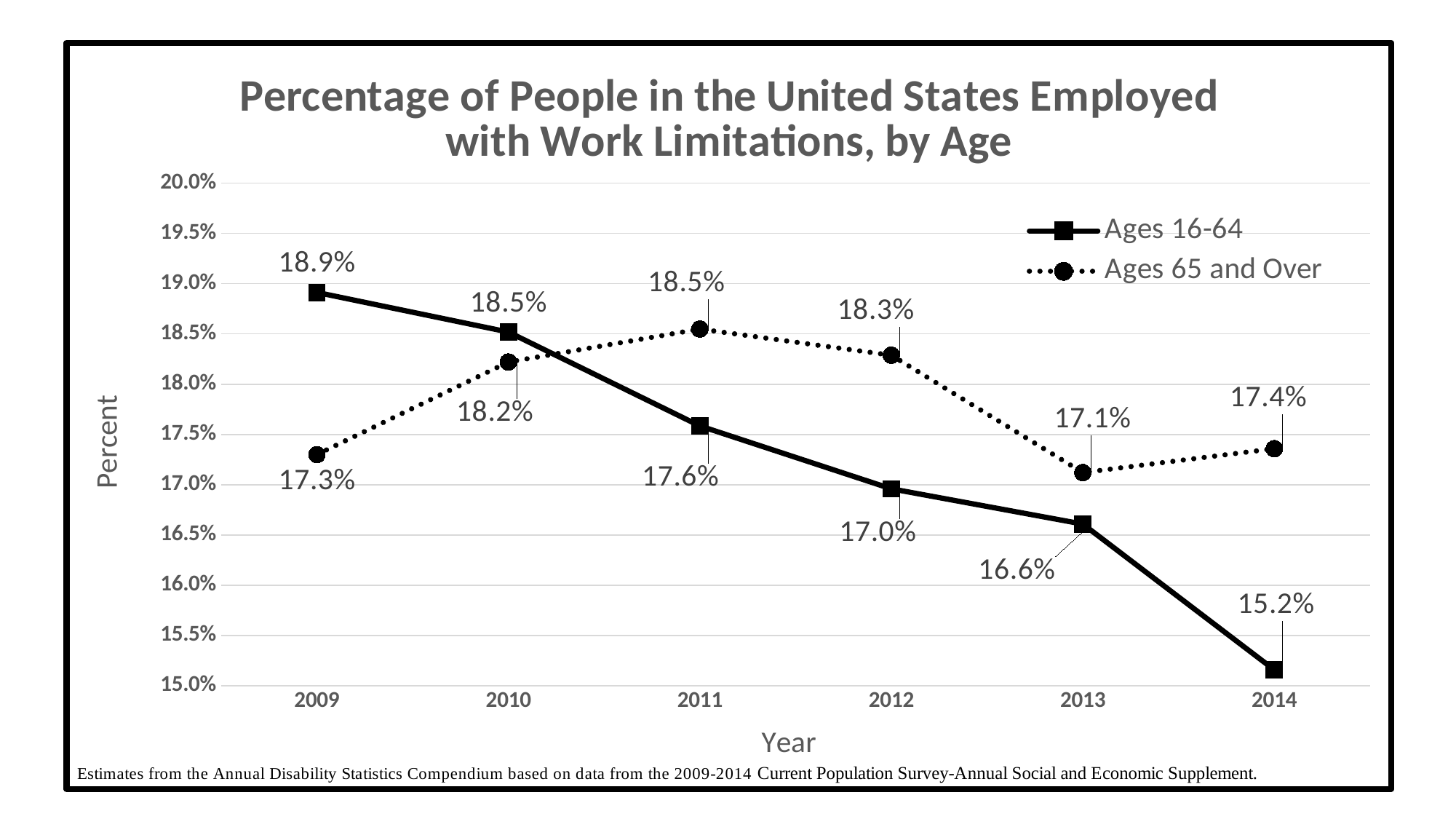
What is the value for Ages 16-64 in 2009? 18.9% In which year is the Ages 65 and Over series highest? 2011 In which year is the Ages 16-64 series lowest? 2014 How many series does the legend list? 2 What is the difference between Ages 65 and Over and Ages 16-64 in 2014? 2.2% Does the Ages 16-64 series rise or fall from 2009 to 2014? Fall What is the value for Ages 16-64 in 2012? 17.0% What is the value for Ages 65 and Over in 2014? 17.4% Which series has the larger value in 2013, Ages 16-64 or Ages 65 and Over? Ages 65 and Over Which series has the larger value in 2009, Ages 16-64 or Ages 65 and Over? Ages 16-64 How many years are shown on the x axis? 6 What kind of chart is shown on the slide? Line chart